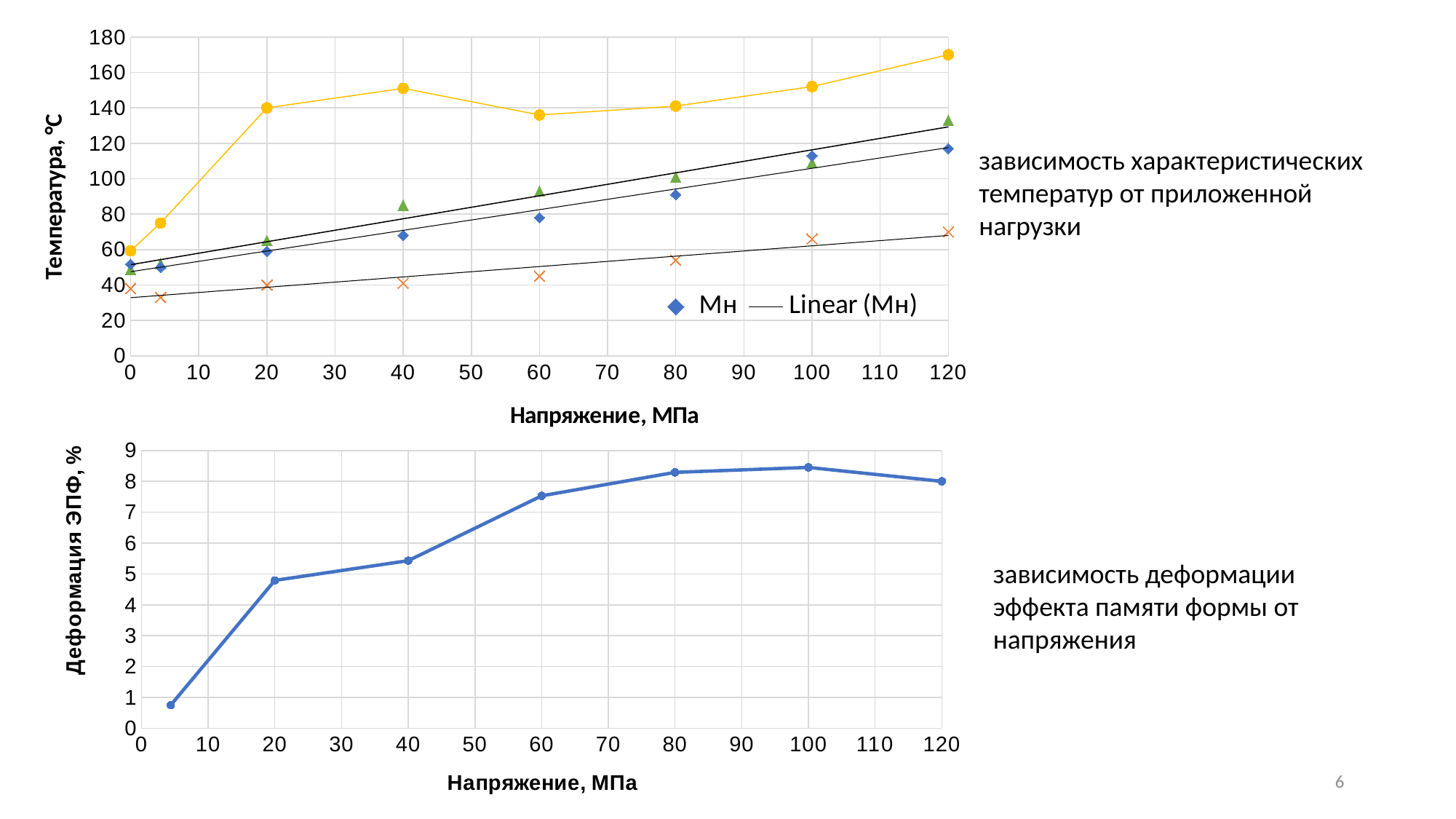
On the bottom chart, is the first plotted value (near 4 МПа) greater or less than 1? less On the bottom chart, how many data points are plotted? 7 On the top chart, how many entries does the legend list? 2 On the top chart, is the value of the yellow circle series at 120 МПа greater or less than 160? greater On the bottom chart, is the value at 20 МПа greater or less than 5? less On the bottom chart, does the deformation generally rise or fall as stress increases from 0 to 100 МПа? rise On the top chart, what is the title of the x axis? Напряжение, МПа On the bottom chart, what kind of chart is it? line chart On the bottom chart, what is the title of the y axis? Деформация ЭПФ, %